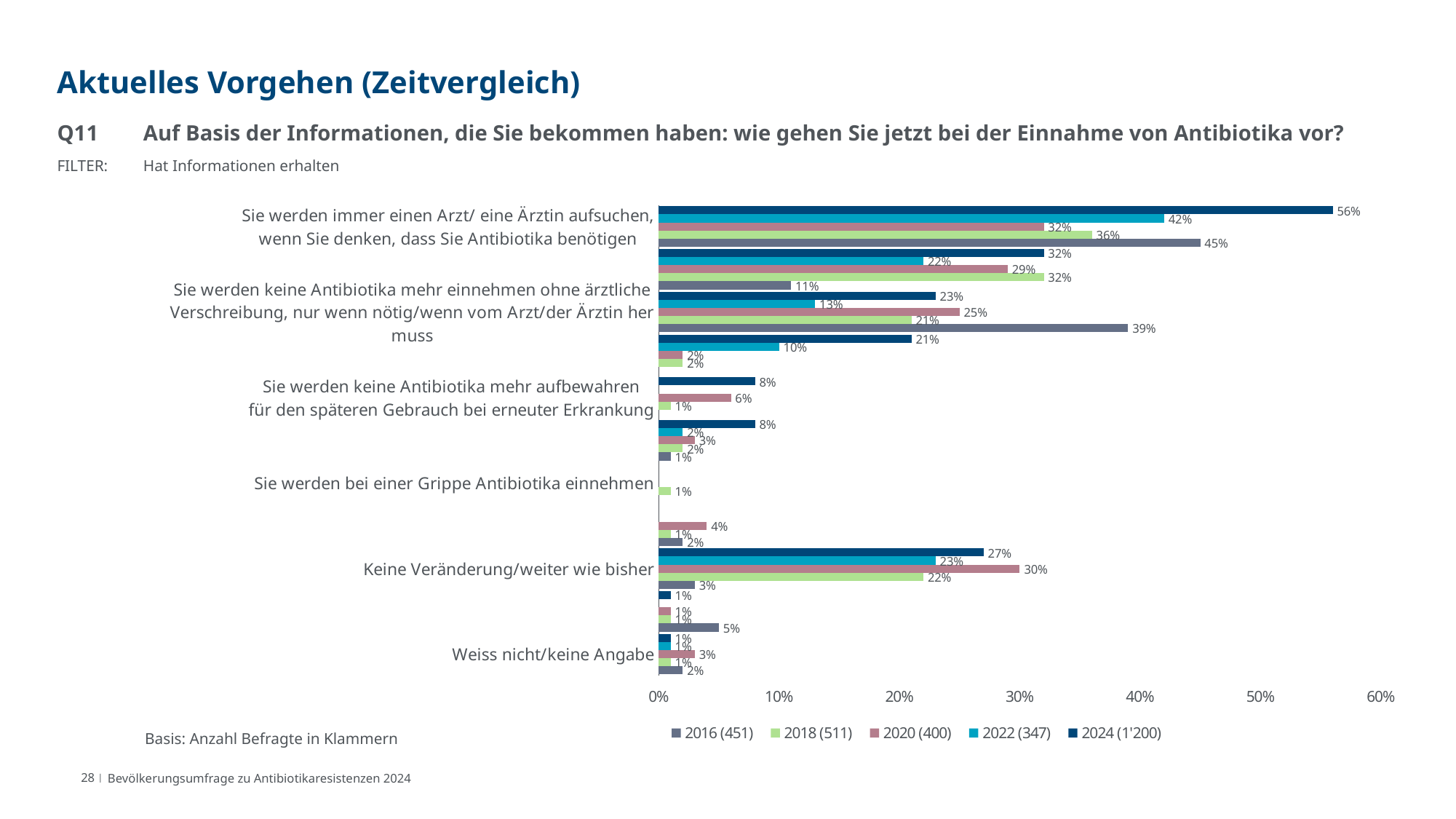
What is the 2016 value for "Keine Veränderung/weiter wie bisher"? 3% What is the difference between the 2024 and 2016 values for "Sie werden immer einen Arzt/ eine Ärztin aufsuchen, wenn Sie denken, dass Sie Antibiotika benötigen"? 11 percentage points What kind of chart is shown on the slide? bar chart What is the 2022 value for "Sie werden immer einen Arzt/ eine Ärztin aufsuchen, wenn Sie denken, dass Sie Antibiotika benötigen"? 42% What is the 2016 value for "Sie werden immer einen Arzt/ eine Ärztin aufsuchen, wenn Sie denken, dass Sie Antibiotika benötigen"? 45% For "Keine Veränderung/weiter wie bisher", which is larger: the 2024 value or the 2022 value? 2024 How many series does the legend list? 5 According to the legend, how many respondents were surveyed in 2024? 1'200 Which year has the highest value for "Sie werden immer einen Arzt/ eine Ärztin aufsuchen, wenn Sie denken, dass Sie Antibiotika benötigen"? 2024 What is the 2020 value for "Weiss nicht/keine Angabe"? 3% What is the 2020 value for "Keine Veränderung/weiter wie bisher"? 30% What is the 2024 value for "Sie werden immer einen Arzt/ eine Ärztin aufsuchen, wenn Sie denken, dass Sie Antibiotika benötigen"? 56%